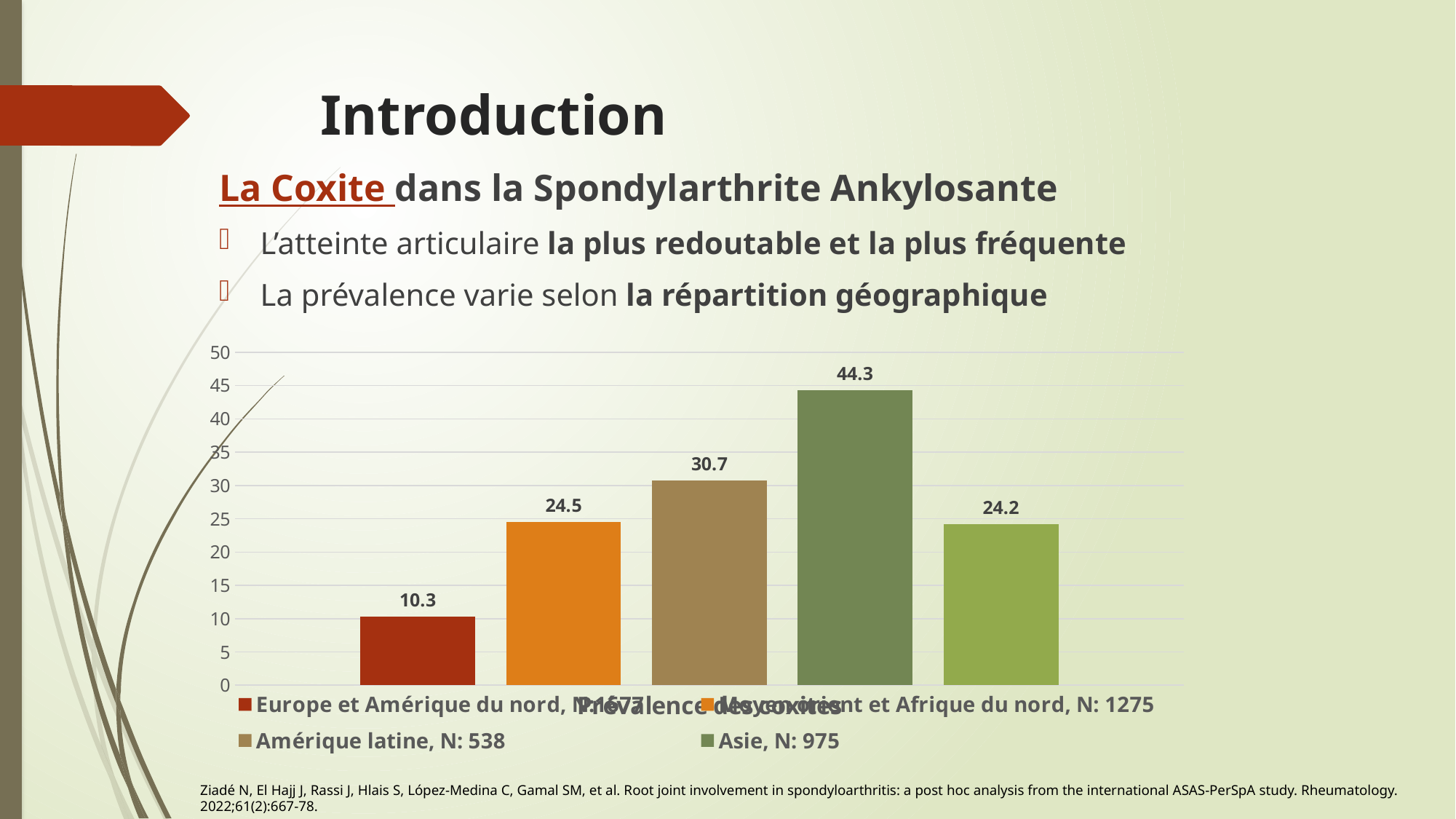
How many bars are plotted in the chart? 5 What is the difference between the value for Asie and the value for Amérique latine? 13.6 What is the difference between the highest and lowest values in the chart? 34 Which is larger, the value for Amérique latine or the value for Europe et Amérique du nord? Amérique latine What is the highest value shown in the chart? 44.3 What type of chart is shown on the slide? bar chart According to the legend, what is the N for Amérique latine? 538 What is the value for Amérique latine? 30.7 Is the value for Asie greater or less than 40? greater What is the lowest value shown in the chart? 10.3 What is the value for Europe et Amérique du nord? 10.3 What is the value for Asie? 44.3